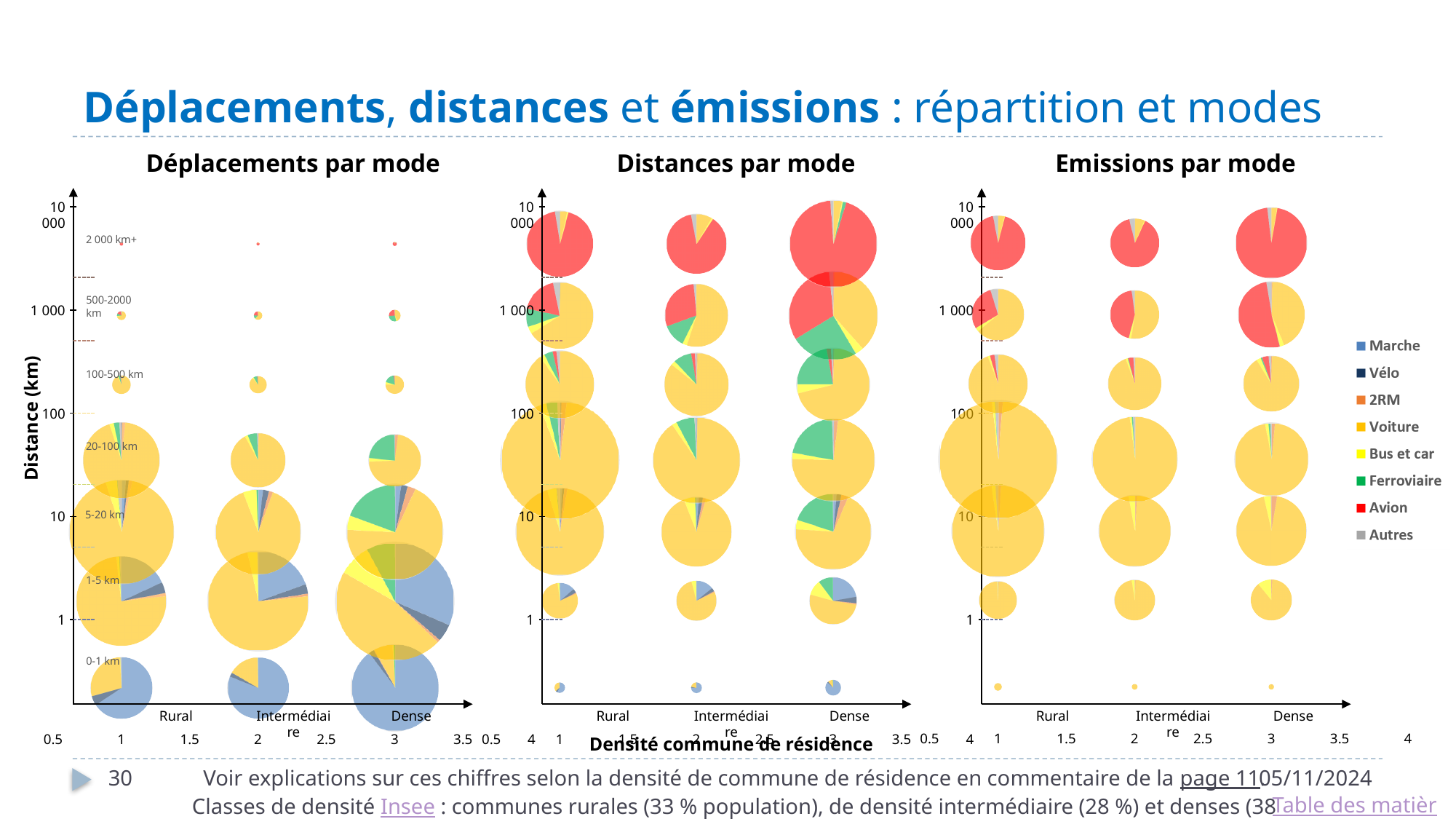
In the 'Distances par mode' chart, which mode dominates the 20-100 km bubble for Rural? Voiture What is the y-axis label of the 'Déplacements par mode' chart? Distance (km) In the 'Distances par mode' chart, which density category has the largest 2 000 km+ bubble? Dense Which colour represents Avion in the legend? Red In the 'Emissions par mode' chart, which mode makes up almost all of the 2 000 km+ bubble for Rural? Avion How many charts are shown on the slide? 3 In the 'Déplacements par mode' chart, how many distance bands are labelled along the y axis? 7 In the 'Emissions par mode' chart, how many density categories are shown on the x axis? 3 In the 'Déplacements par mode' chart, which density category has the largest 0-1 km bubble? Dense What is the title of the leftmost chart? Déplacements par mode In the 'Déplacements par mode' chart, which mode dominates the 0-1 km bubble for Dense? Marche How many series does the legend list? 8